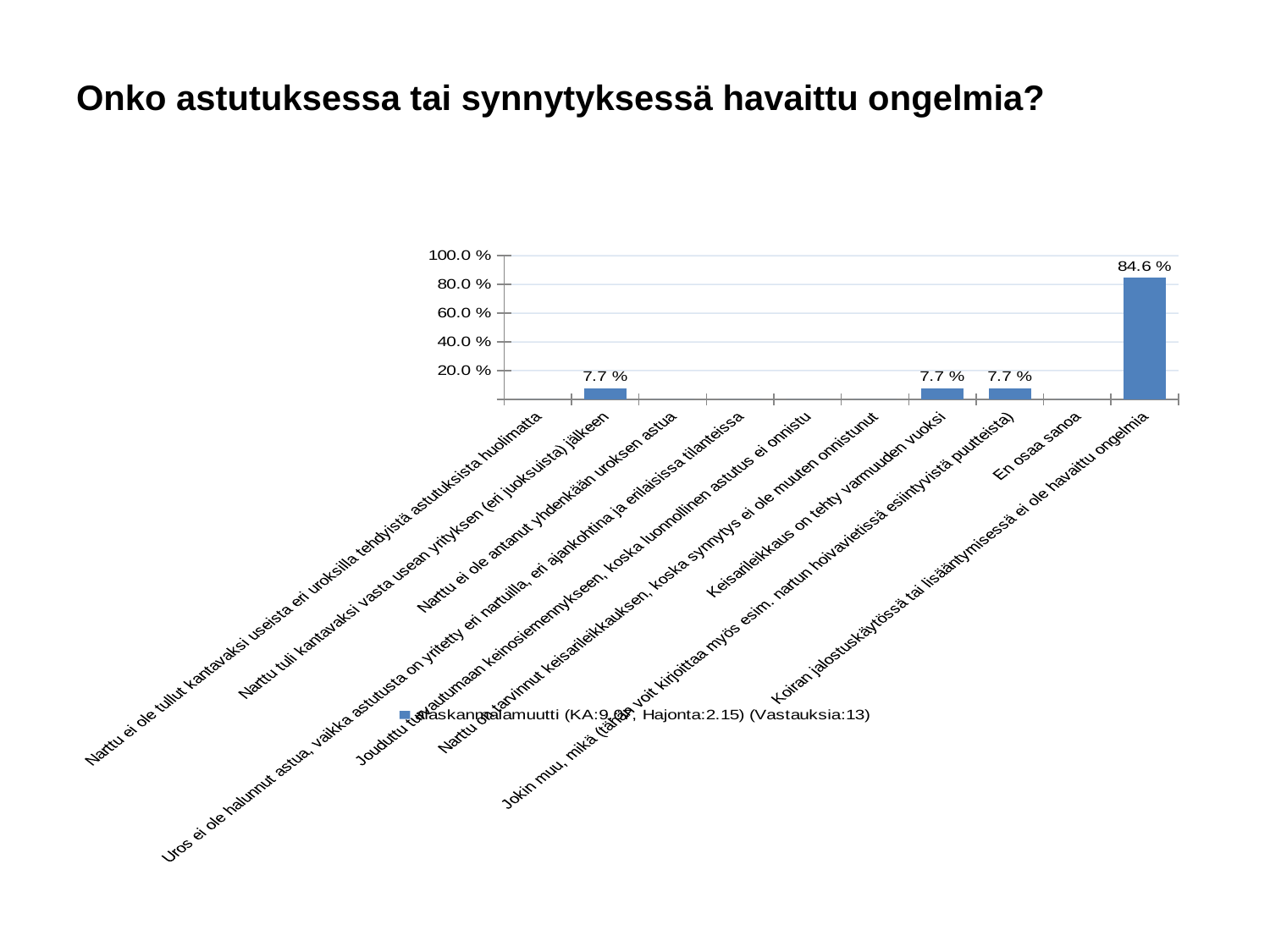
Which is larger: the value for "Koiran jalostuskäytössä tai lisääntymisessä ei ole havaittu ongelmia" or the value for "Jokin muu, mikä"? Koiran jalostuskäytössä tai lisääntymisessä ei ole havaittu ongelmia Is the value for "Keisarileikkaus on tehty varmuuden vuoksi" greater or less than 20.0 %? less What is the value for "Narttu tuli kantavaksi vasta usean yrityksen (eri juoksuista) jälkeen"? 7.7 % How many categories are shown on the x axis? 10 Which category has the highest value? Koiran jalostuskäytössä tai lisääntymisessä ei ole havaittu ongelmia Is the value for "Koiran jalostuskäytössä tai lisääntymisessä ei ole havaittu ongelmia" greater or less than 80.0 %? greater What kind of chart is shown on the slide? bar chart How many series does the legend list? 1 What is the value for "Keisarileikkaus on tehty varmuuden vuoksi"? 7.7 % What is the value for "Koiran jalostuskäytössä tai lisääntymisessä ei ole havaittu ongelmia"? 84.6 % What is the difference between the value for "Koiran jalostuskäytössä tai lisääntymisessä ei ole havaittu ongelmia" and the value for "Keisarileikkaus on tehty varmuuden vuoksi"? 76.9 %